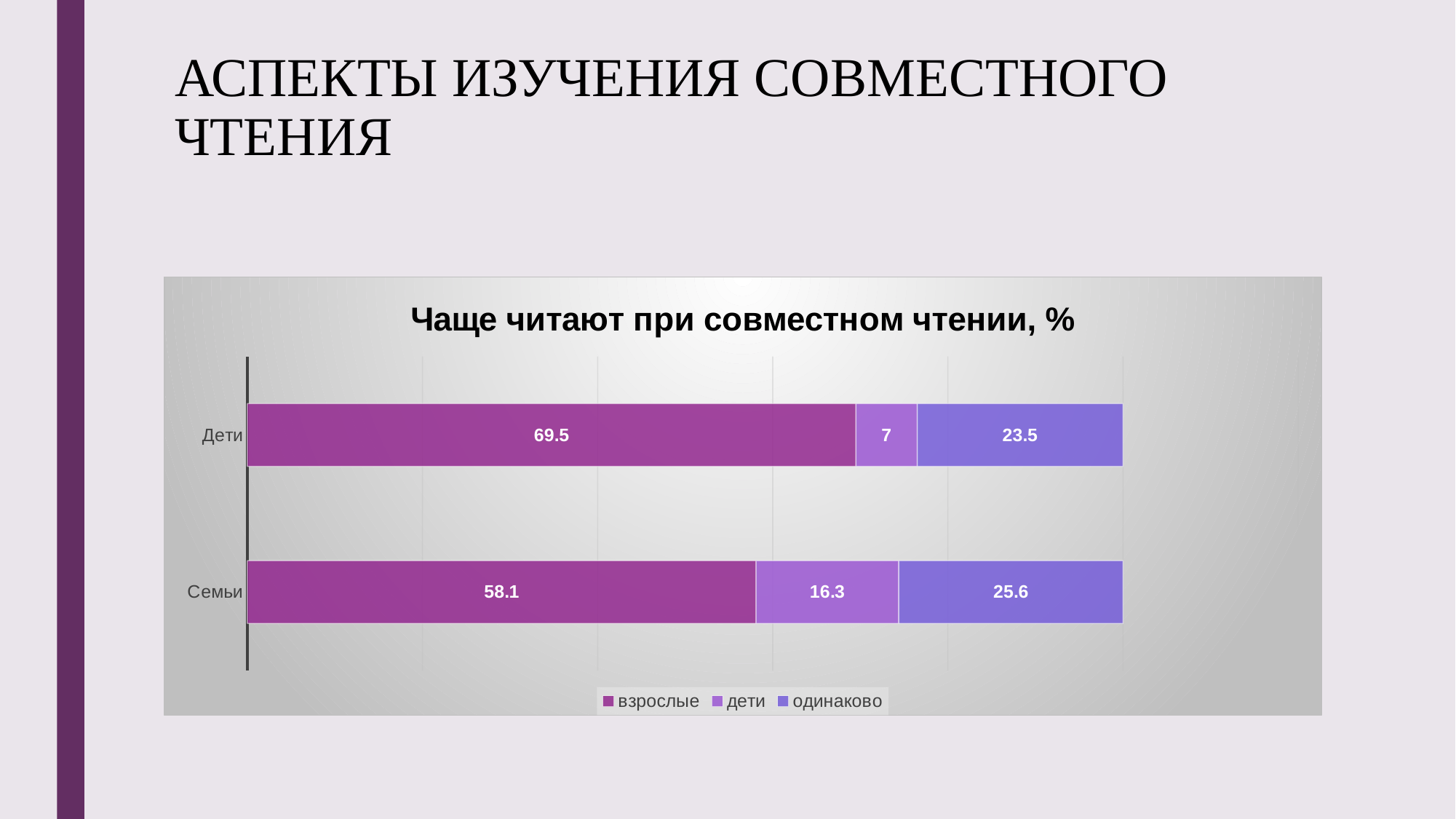
What type of chart is shown on the slide? Stacked bar chart What is the value for одинаково in the Дети bar? 23.5 What is the total of the stacked bar for Семьи? 100 What is the difference between the взрослые values for Дети and Семьи? 11.4 Which category has the lower value for дети? Дети What is the value for дети in the Семьи bar? 16.3 What is the difference between the дети values for Семьи and Дети? 9.3 How many categories are shown on the chart? 2 How many series does the legend list? 3 What is the value for взрослые in the Дети bar? 69.5 Which category has the higher value for взрослые, Дети or Семьи? Дети What is the value for одинаково in the Семьи bar? 25.6